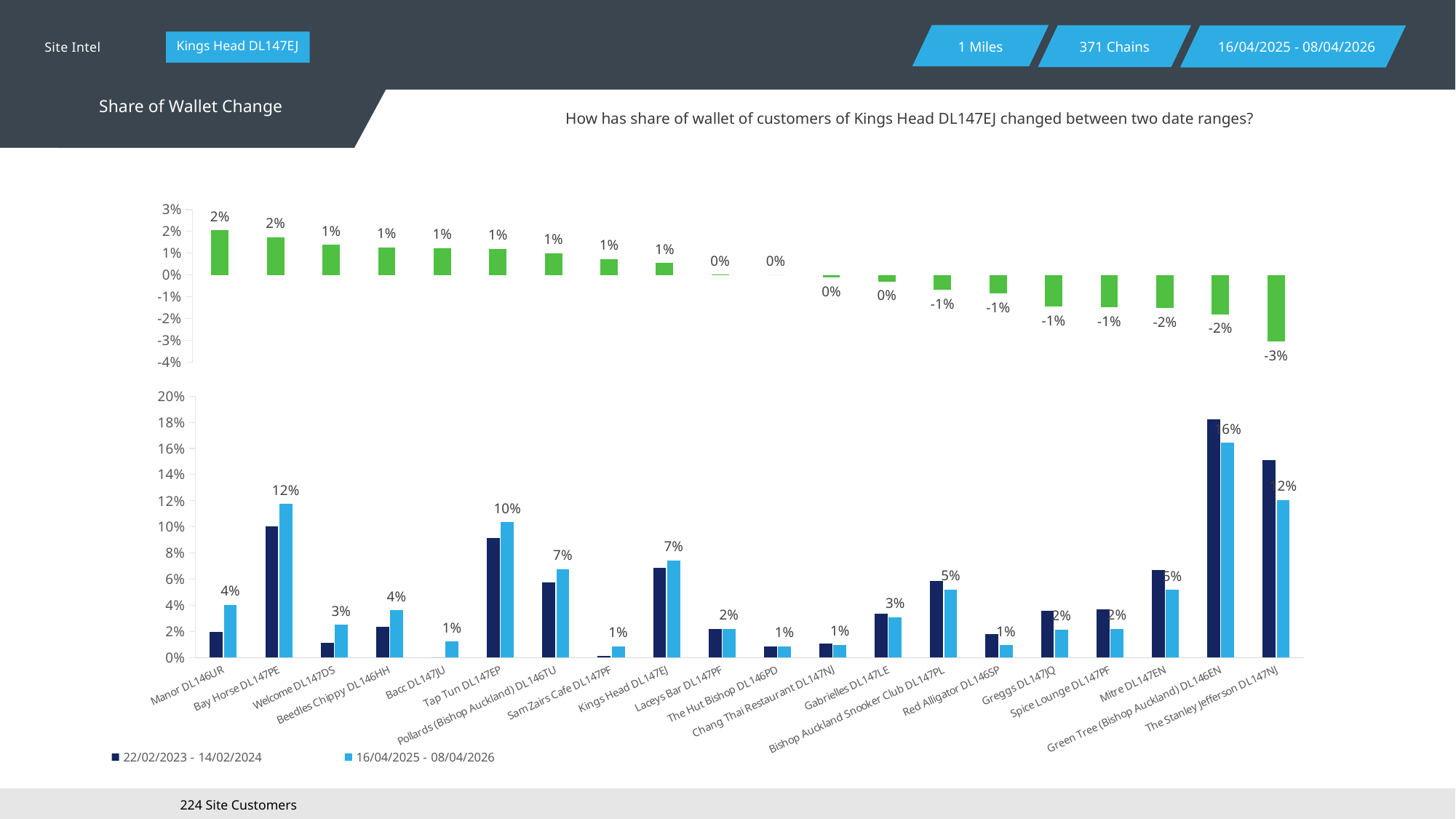
How many series does the legend of the bottom chart list? 2 In the bottom chart, which category has the highest share of wallet in the 16/04/2025 - 08/04/2026 period? Green Tree (Bishop Auckland) DL146EN In the bottom chart, what is the share of wallet for Green Tree (Bishop Auckland) DL146EN in the 16/04/2025 - 08/04/2026 period? 16% In the bottom chart, is the 22/02/2023 - 14/02/2024 value for Mitre DL147EN greater or less than 6%? greater In the bottom chart, what is the difference between the 16/04/2025 - 08/04/2026 values for Bay Horse DL147PE and Tap Tun DL147EP? 2% In the bottom chart, what is the share of wallet for Bay Horse DL147PE in the 16/04/2025 - 08/04/2026 period? 12% What kind of chart is the top chart? bar chart In the bottom chart, which is larger for the 16/04/2025 - 08/04/2026 period: Bay Horse DL147PE or Kings Head DL147EJ? Bay Horse DL147PE In the bottom chart, what is the share of wallet for Kings Head DL147EJ in the 16/04/2025 - 08/04/2026 period? 7% How many categories are shown on the x axis of the bottom chart? 20 What is the lowest value shown in the top chart? -3% In the bottom chart, is the 22/02/2023 - 14/02/2024 value for The Stanley Jefferson DL147NJ greater or less than 14%? greater